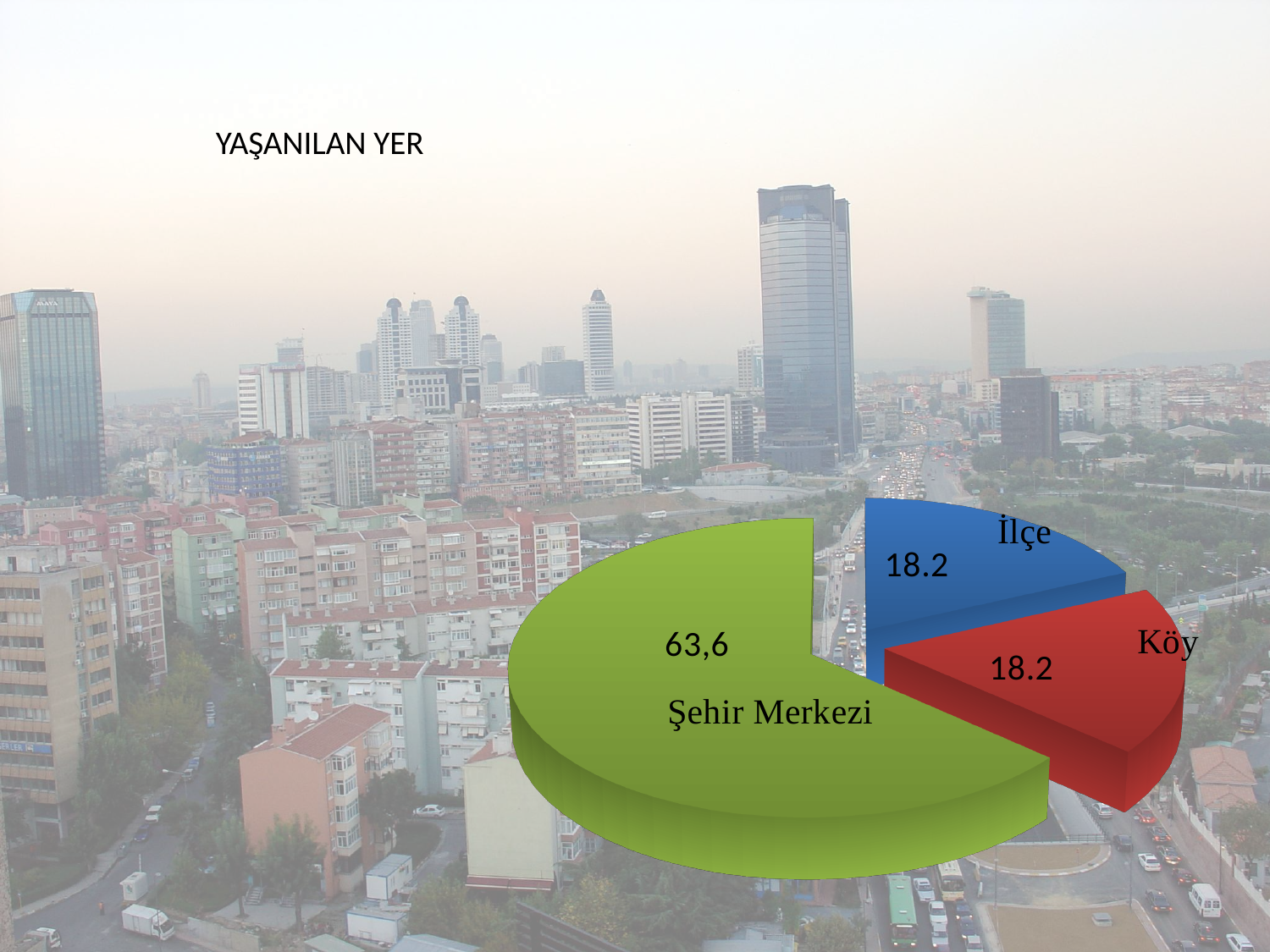
What is the difference between the value for Şehir Merkezi and the value for Köy? 45.4 Do İlçe and Köy have the same value? Yes What is the value shown for Köy? 18.2 What is the value shown for İlçe? 18.2 Which category has the largest slice of the pie? Şehir Merkezi How many slices does the pie chart have? 3 What kind of chart is shown on the slide? pie chart What is the value shown for Şehir Merkezi? 63,6 Which is larger, the value for Şehir Merkezi or the value for İlçe? Şehir Merkezi What colour is the Şehir Merkezi slice? green What is the title of the chart? YAŞANILAN YER